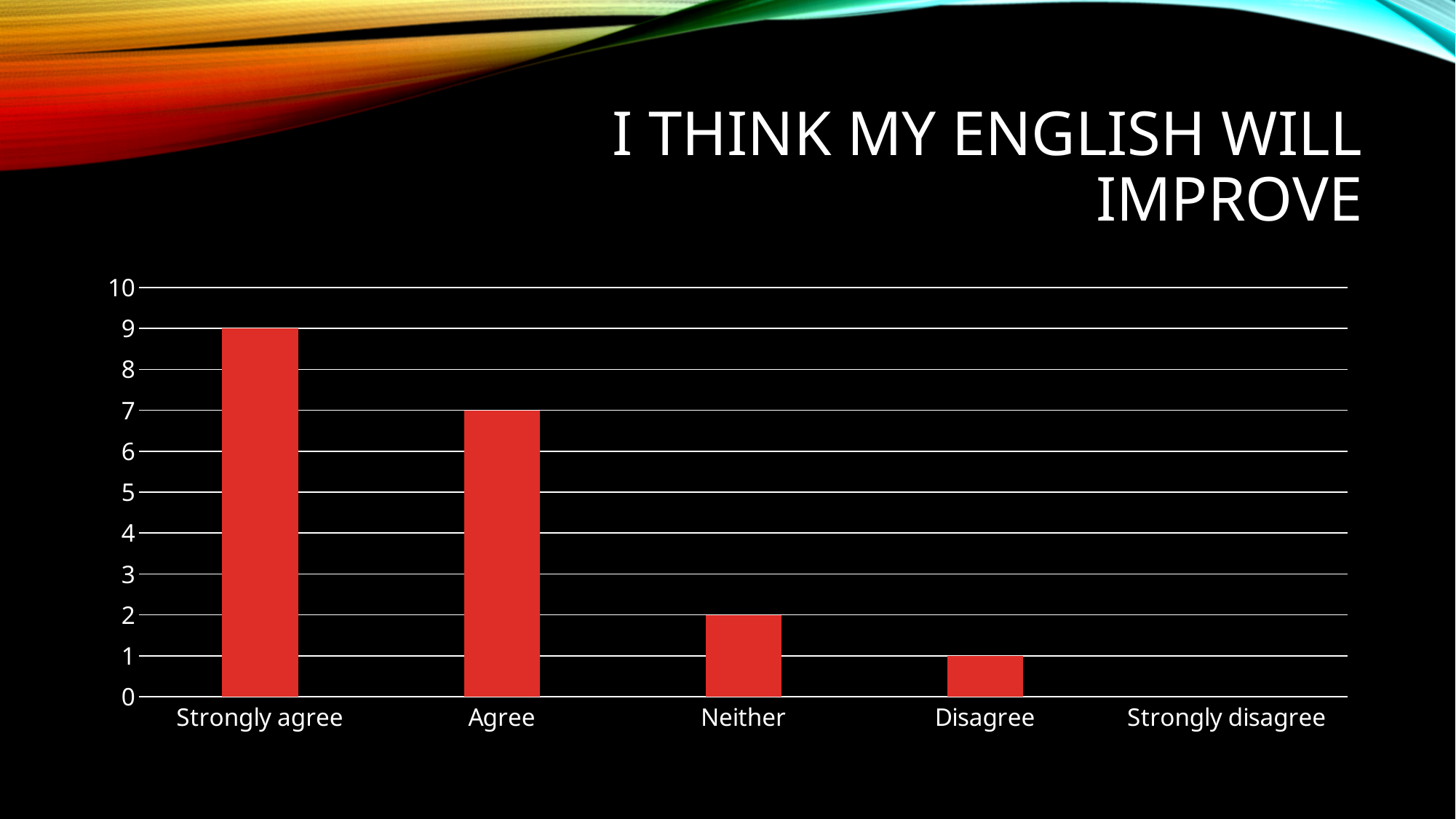
Which is larger, the value for Neither or the value for Disagree? Neither What is the value for Strongly agree? 9 Which category has the highest value? Strongly agree What is the value for Disagree? 1 What is the value for Agree? 7 Which category has the lowest value? Strongly disagree Is the value for Agree greater or less than 5? greater How many categories are shown on the x axis? 5 What is the value for Neither? 2 What is the difference between the values for Strongly agree and Agree? 2 What is the title of the slide? I think my English will improve What kind of chart is shown on the slide? bar chart